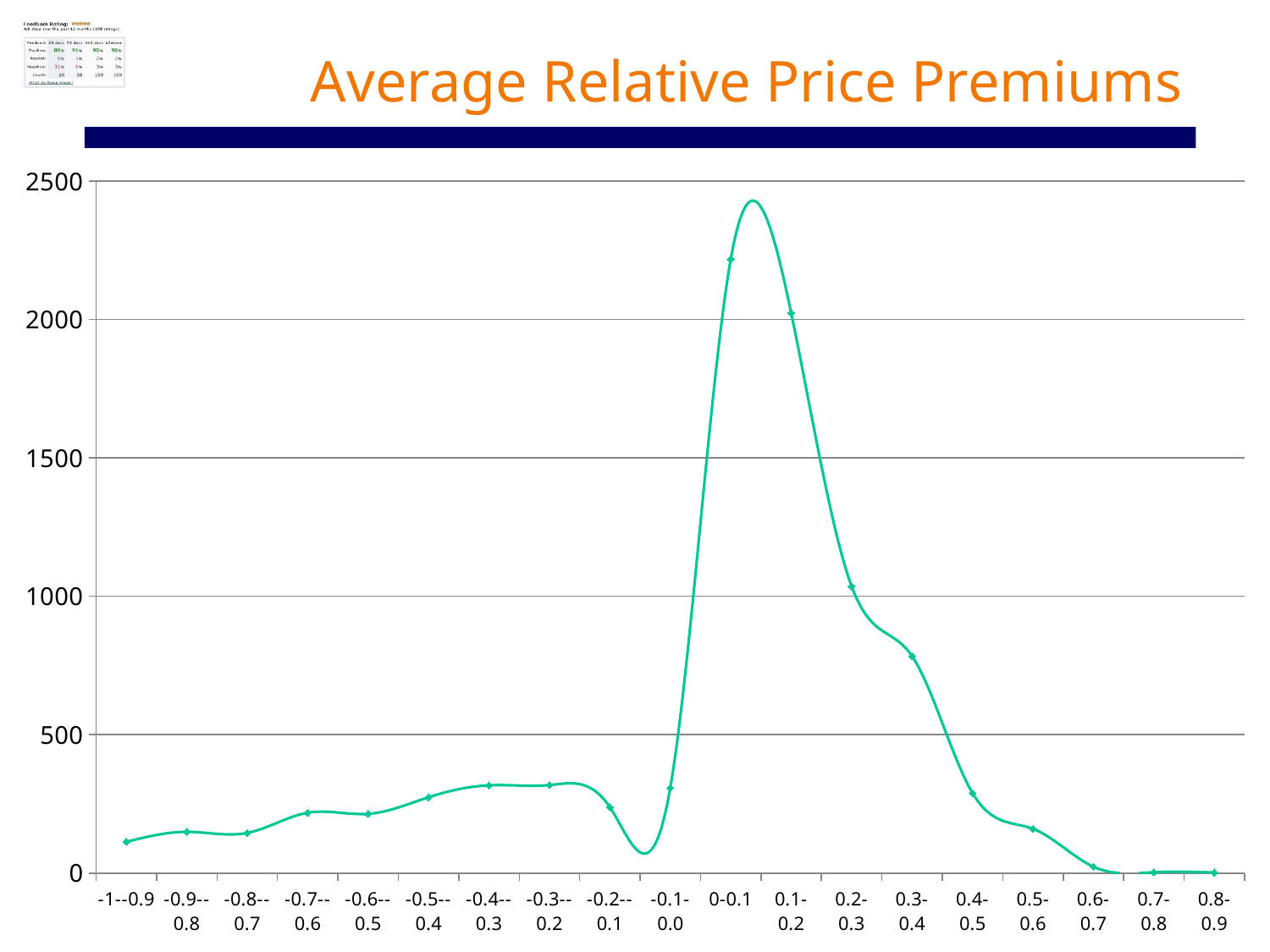
What kind of chart is shown on the slide? line chart Which is larger, the value for -0.1-0.0 or the value for 0-0.1? 0-0.1 Is the value for 0-0.1 greater or less than 2000? greater Is the value for -0.4--0.3 greater or less than 500? less Do the values rise or fall along the x axis from 0-0.1 to 0.8-0.9? fall Is the value for 0.1-0.2 greater or less than 1500? greater Which is larger, the value for 0.2-0.3 or the value for 0.3-0.4? 0.2-0.3 Which category has the highest value? 0-0.1 How many categories are shown along the x axis? 19 What is the title of the chart? Average Relative Price Premiums